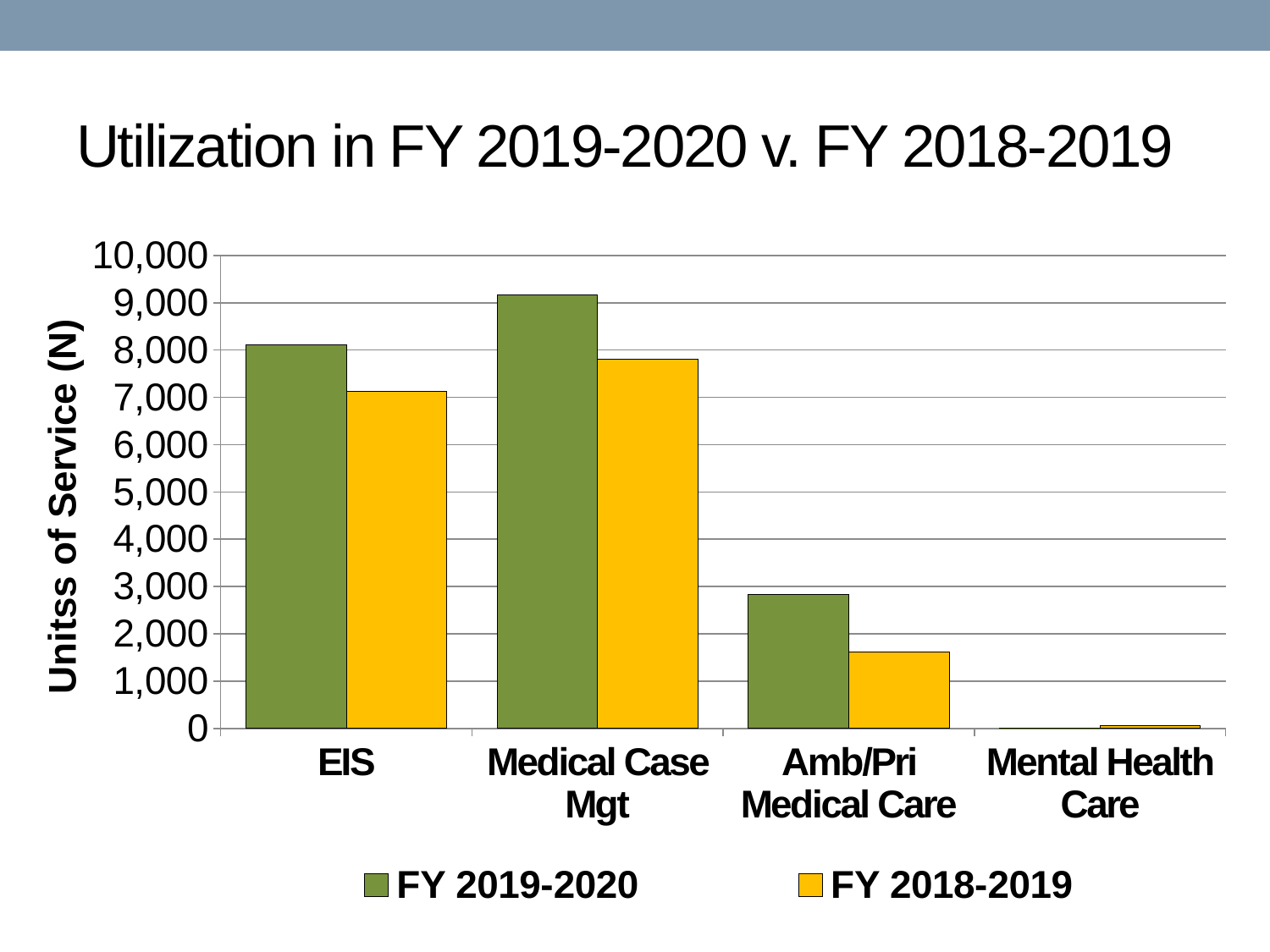
What is the label on the vertical axis? Unitss of Service (N) For EIS, which series has the larger value, FY 2019-2020 or FY 2018-2019? FY 2019-2020 What is the title of the chart? Utilization in FY 2019-2020 v. FY 2018-2019 Which category has the highest FY 2019-2020 value? Medical Case Mgt How many categories are shown on the x axis? 4 Is the FY 2018-2019 value for Amb/Pri Medical Care greater or less than 2,000? less Is the FY 2019-2020 value for Amb/Pri Medical Care greater or less than 3,000? less How many series does the legend list? 2 Which category has the lowest FY 2018-2019 value? Mental Health Care What kind of chart is shown on the slide? bar chart Is the FY 2018-2019 value for Medical Case Mgt greater or less than 8,000? less